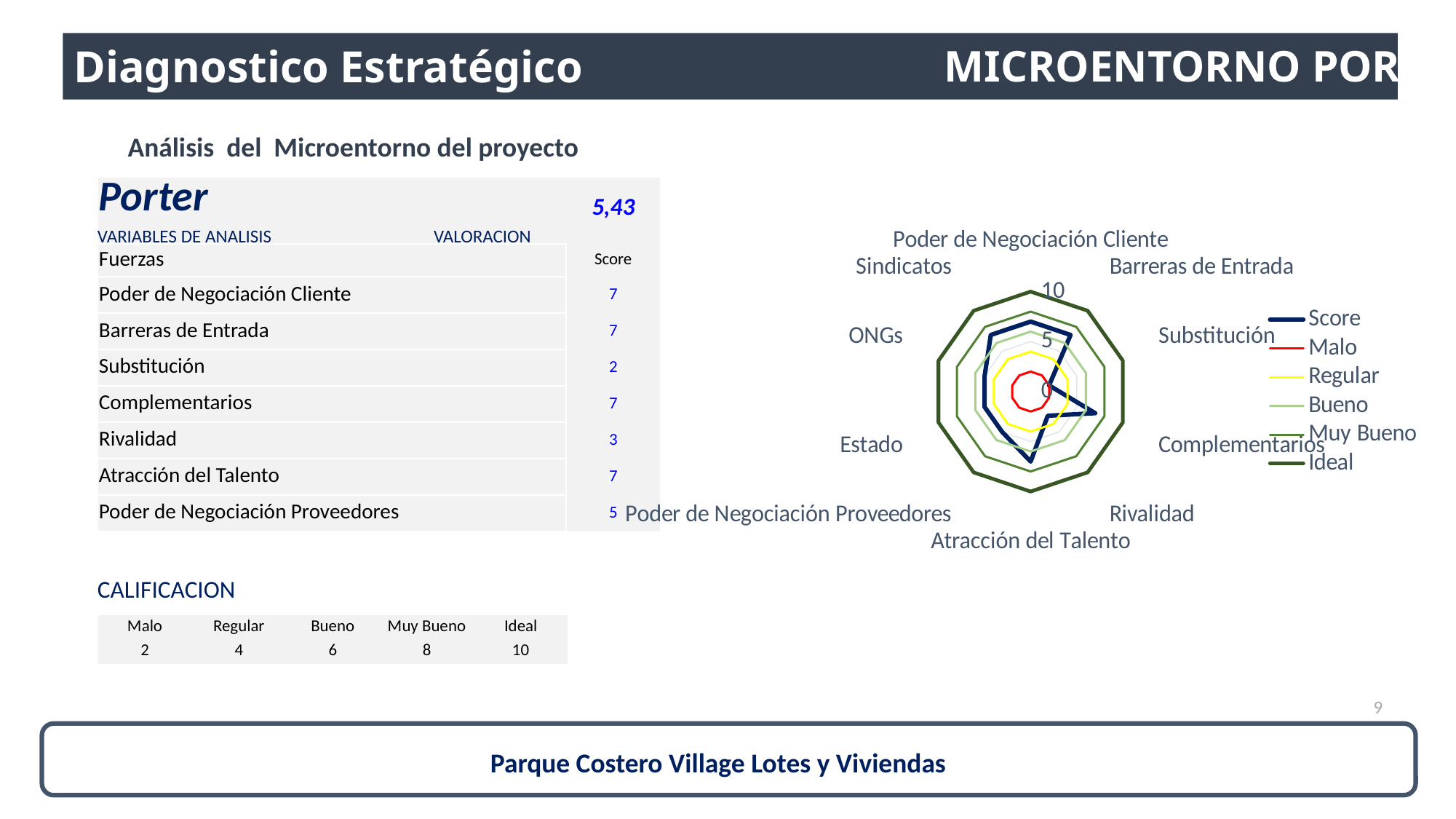
What is the Score value for Poder de Negociación Proveedores? 5 What is the difference between the Score for Complementarios and the Score for Rivalidad? 4 Which has the higher Score, Barreras de Entrada or Substitución? Barreras de Entrada What is the Score value for Substitución? 2 How many categories are plotted around the radar chart? 10 What is the highest value shown on the radar chart's axis? 10 Is the Score value for Atracción del Talento greater or less than 5? greater Which legend entry of the radar chart is drawn in red? Malo Is the Score value for Substitución greater or less than 5? less What is the Score value for Rivalidad? 3 What kind of chart is shown on the right of the slide? radar chart How many series does the legend of the radar chart list? 6